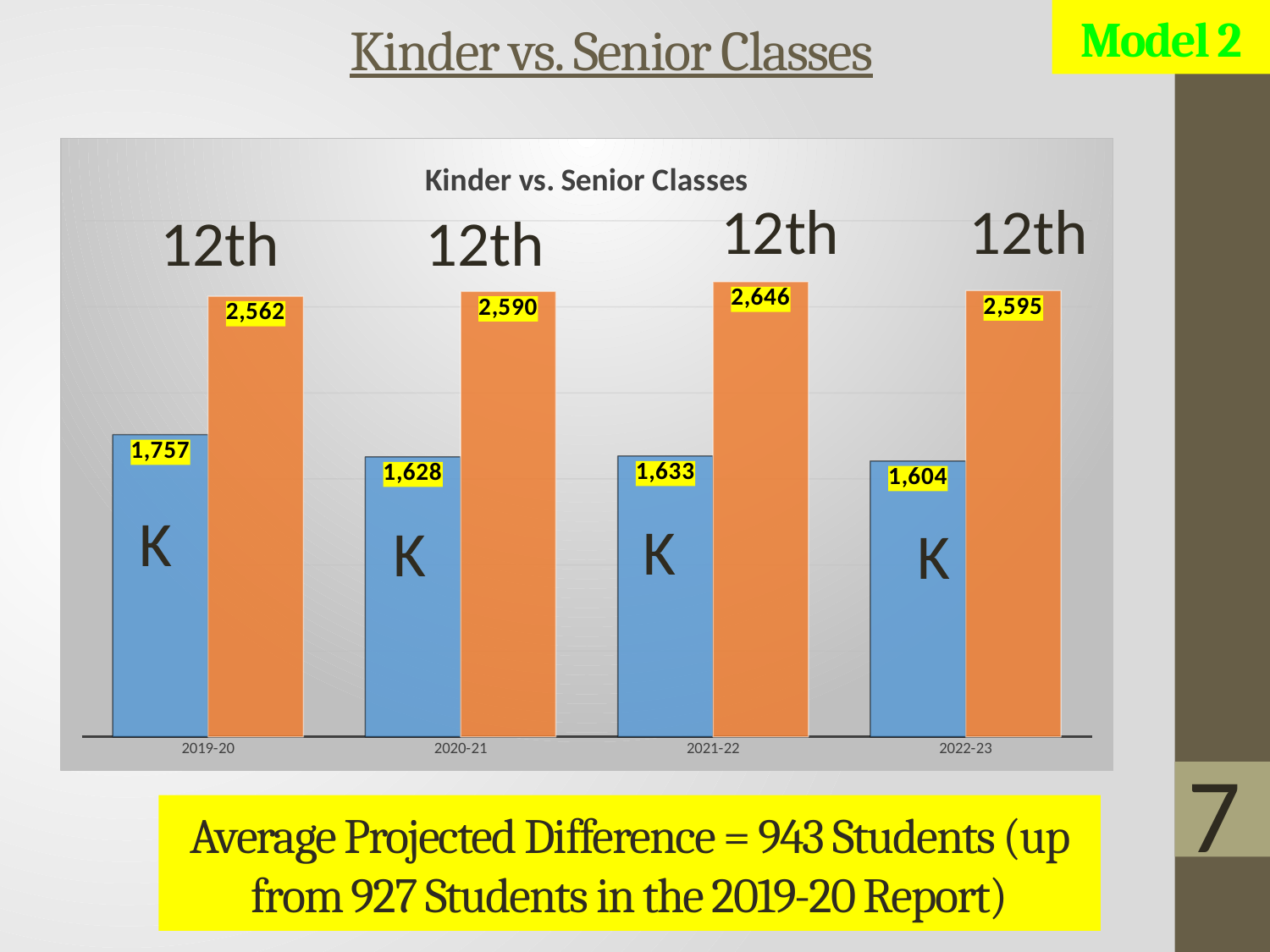
What is the difference between the 12th and K values in 2021-22? 1,013 What is the value for 12th in 2020-21? 2,590 How many school years are shown on the x axis? 4 What kind of chart is shown on the slide? Bar chart In which year is the K value lowest? 2022-23 What is the value for 12th in 2021-22? 2,646 Which is larger, the K value in 2019-20 or the K value in 2020-21? 2019-20 What is the title of the chart? Kinder vs. Senior Classes What is the difference between the 12th and K values in 2019-20? 805 What is the value for K in 2019-20? 1,757 What is the value for K in 2022-23? 1,604 In which year is the 12th value highest? 2021-22